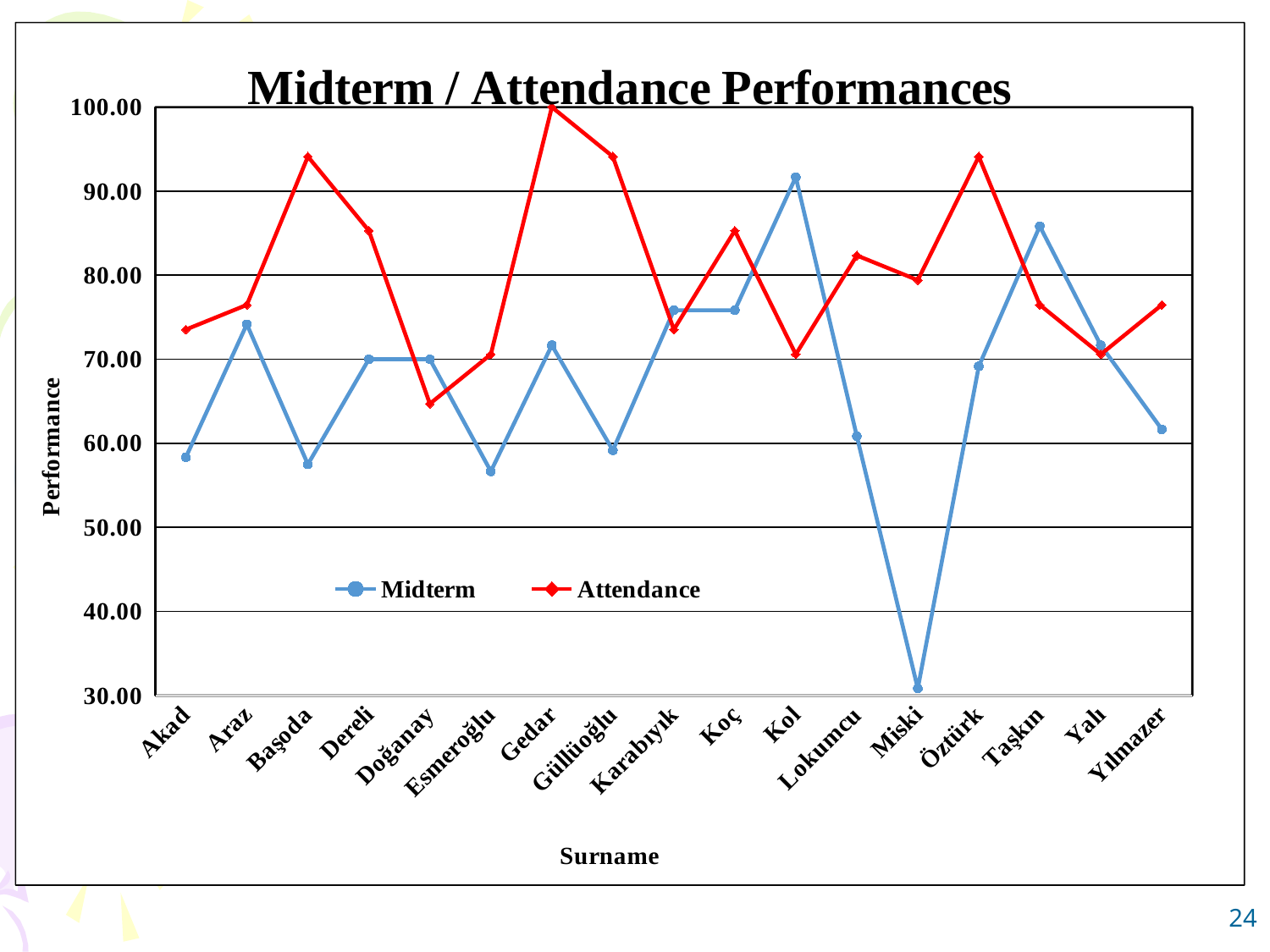
Is the Attendance value for Başoda greater or less than 90.00? greater How many series does the legend list? 2 Is the Midterm value for Kol greater or less than 90.00? greater Which surname has the highest Midterm value? Kol What kind of chart is shown on the slide? Line chart For Miski, which is larger: the Midterm value or the Attendance value? Attendance Is the Midterm value for Miski greater or less than 40.00? less Which surname has the lowest Midterm value? Miski How many surnames are plotted along the x axis? 17 Which surname has the lowest Attendance value? Doğanay What is the title of the chart? Midterm / Attendance Performances Which surname has the highest Attendance value? Gedar